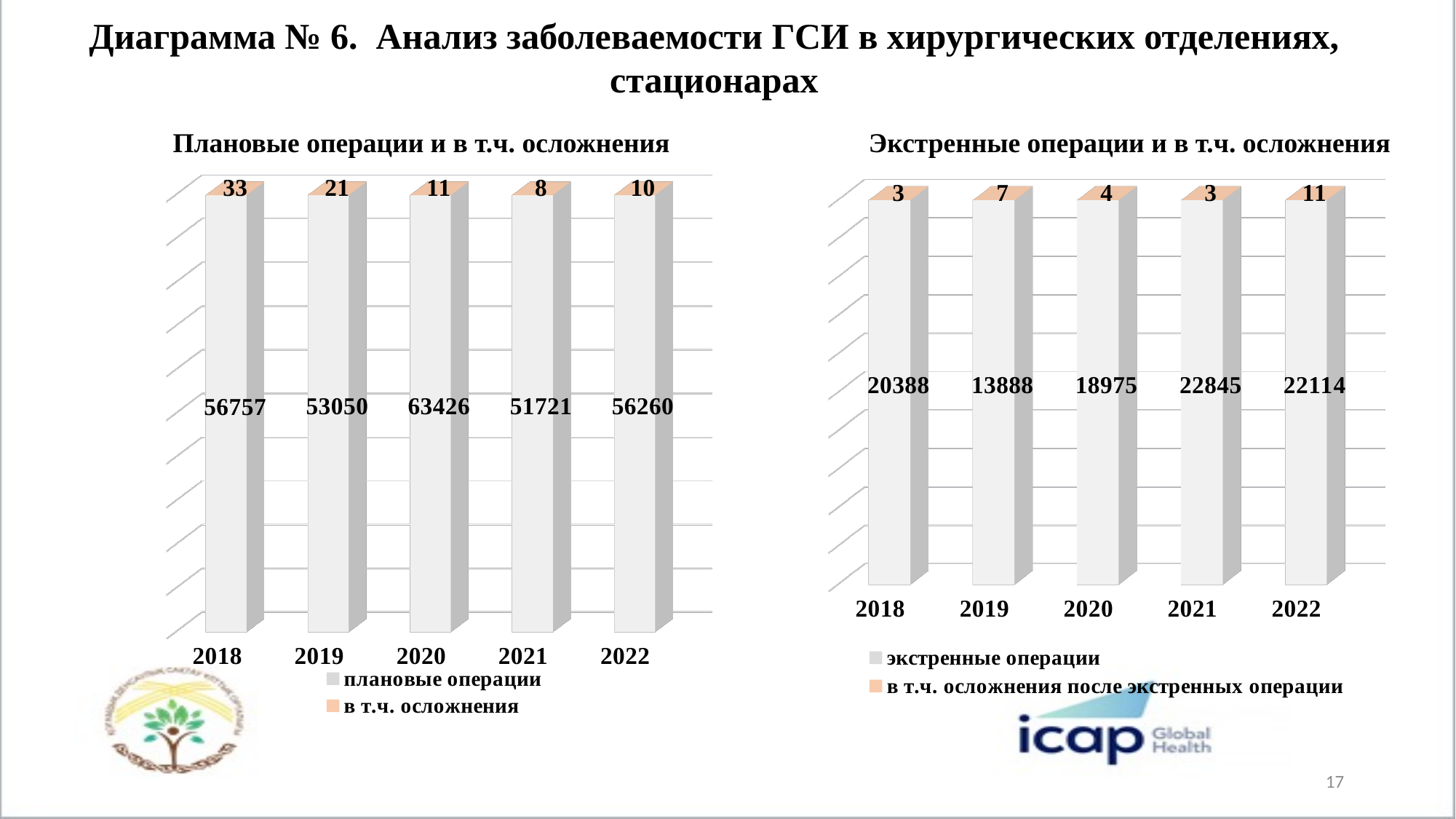
In the chart titled "Экстренные операции и в т.ч. осложнения", what is the value of экстренные операции for 2021? 22845 In the chart titled "Экстренные операции и в т.ч. осложнения", what is the total of the stacked bar for 2019? 13895 In the chart titled "Плановые операции и в т.ч. осложнения", what is the value of в т.ч. осложнения for 2018? 33 In the chart titled "Плановые операции и в т.ч. осложнения", which year has the highest value of плановые операции? 2020 How many series does the legend list in the chart titled "Экстренные операции и в т.ч. осложнения"? 2 What kind of chart is the chart titled "Плановые операции и в т.ч. осложнения"? Stacked bar chart In the chart titled "Экстренные операции и в т.ч. осложнения", which is larger: экстренные операции in 2020 or in 2021? 2021 In the chart titled "Экстренные операции и в т.ч. осложнения", which year has the lowest value of экстренные операции? 2019 In the chart titled "Плановые операции и в т.ч. осложнения", which year has the lowest value of в т.ч. осложнения? 2021 In the chart titled "Плановые операции и в т.ч. осложнения", what is the difference between the в т.ч. осложнения values for 2018 and 2019? 12 In the chart titled "Плановые операции и в т.ч. осложнения", what is the value of плановые операции for 2020? 63426 In the chart titled "Экстренные операции и в т.ч. осложнения", which year has the highest value of в т.ч. осложнения после экстренных операции? 2022